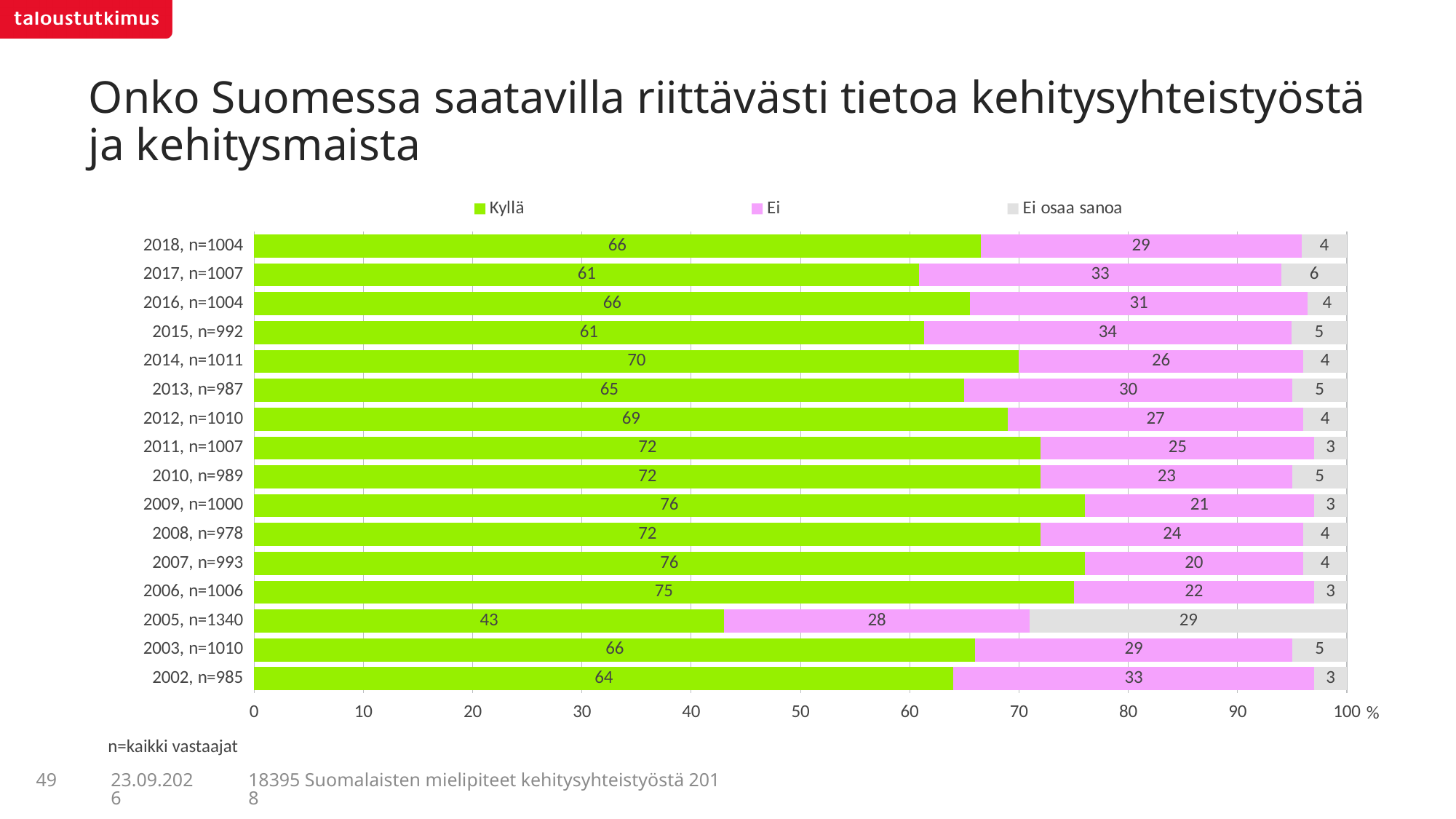
What is the Kyllä value for 2018, n=1004? 66 What kind of chart is shown on the slide? Stacked bar chart Which year has the highest Ei osaa sanoa value? 2005, n=1340 Which has the larger Kyllä value, 2014, n=1011 or 2013, n=987? 2014, n=1011 How many year categories are shown in the chart? 16 What is the Ei osaa sanoa value for 2005, n=1340? 29 How many series does the legend list? 3 What is the difference between the Kyllä values for 2014, n=1011 and 2015, n=992? 9 What is the Ei value for 2015, n=992? 34 Which year has the highest Ei value? 2015, n=992 Which year has the lowest Kyllä value? 2005, n=1340 What is the total of the stacked bar for 2005, n=1340? 100